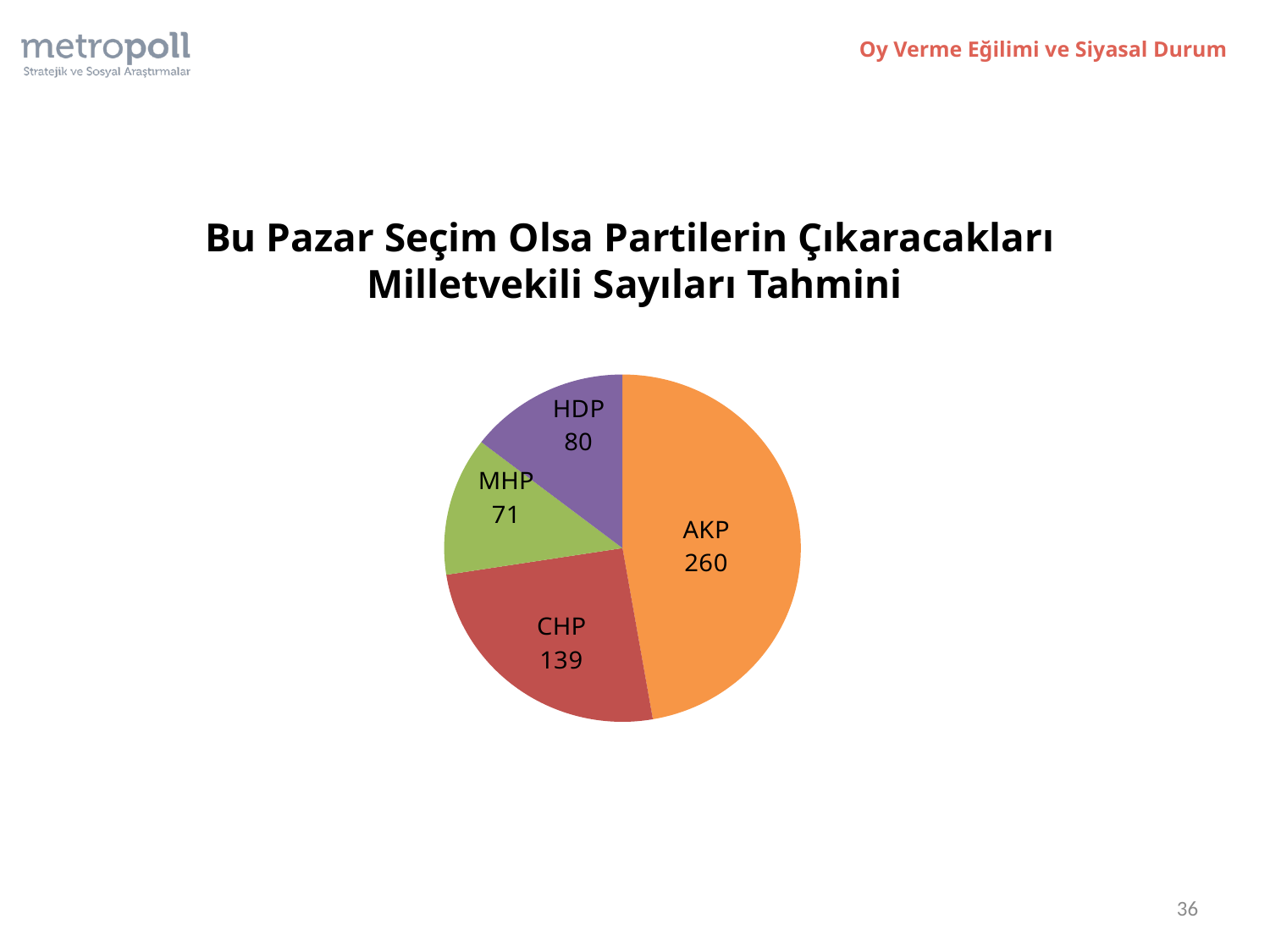
Which party has the largest slice of the pie? AKP Which party has the smallest slice of the pie? MHP How many parties are shown in the pie chart? 4 What is the estimated number of seats for AKP? 260 What is the total number of seats across all four parties in the chart? 550 What is the estimated number of seats for MHP? 71 Which party has a higher seat estimate, HDP or MHP? HDP What is the difference between the seat estimates for AKP and CHP? 121 What type of chart is shown on the slide? Pie chart What is the estimated number of seats for CHP? 139 What is the difference between the seat estimates for HDP and MHP? 9 What is the estimated number of seats for HDP? 80